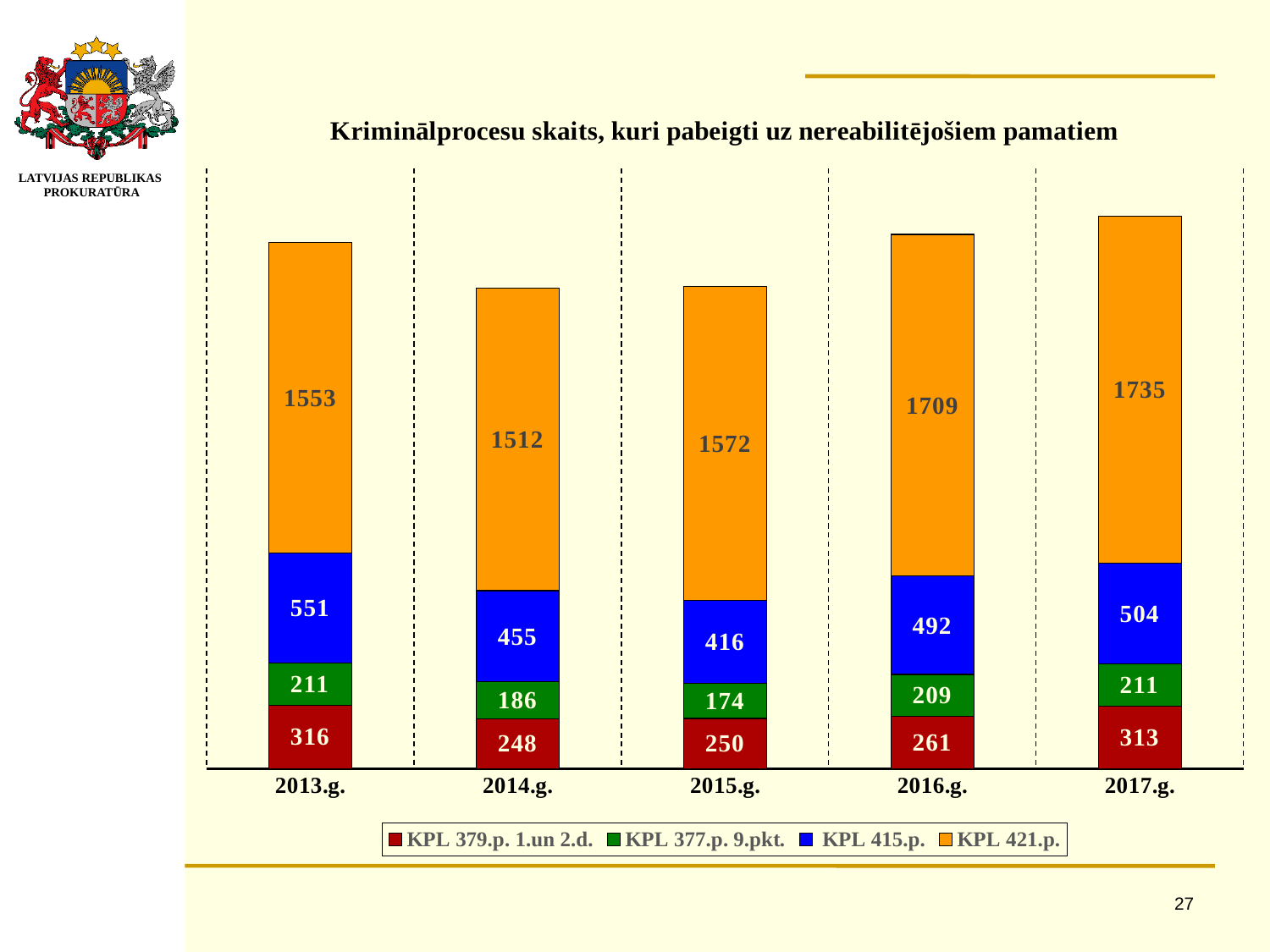
Which is larger, the KPL 379.p. 1.un 2.d. value in 2013.g. or in 2017.g.? 2013.g. What is the value for KPL 379.p. 1.un 2.d. in 2014.g.? 248 How many series does the legend list? 4 In which year is the KPL 377.p. 9.pkt. value lowest? 2015.g. In which year is the KPL 421.p. value highest? 2017.g. What is the value for KPL 421.p. in 2017.g.? 1735 What kind of chart is shown on the slide? Stacked bar chart What is the difference between the KPL 415.p. values in 2013.g. and 2014.g.? 96 What is the total of the stacked bar for 2016.g.? 2671 How many years are shown on the x axis? 5 What is the value for KPL 415.p. in 2015.g.? 416 What is the total of the stacked bar for 2013.g.? 2631